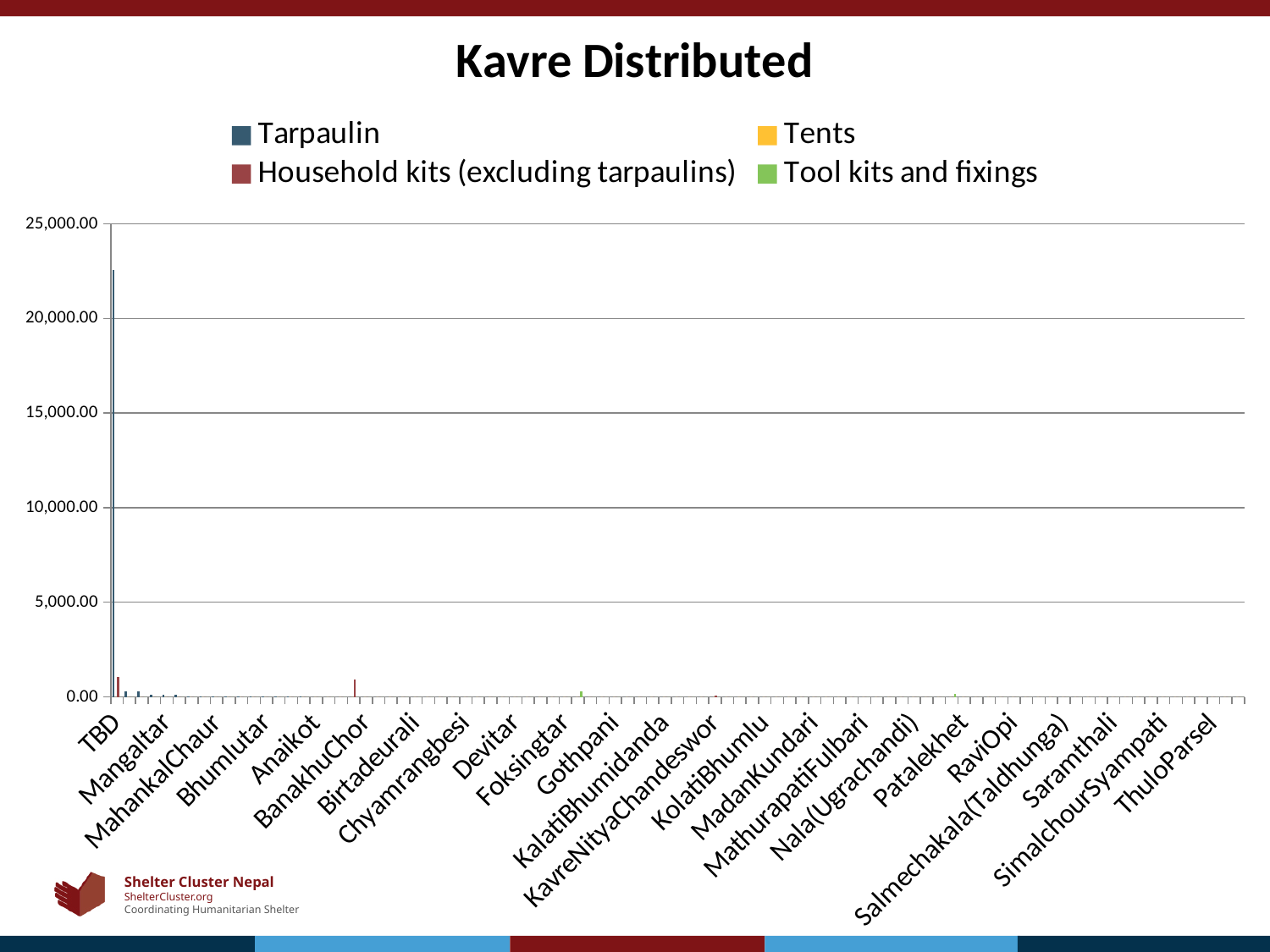
Is the Tarpaulin value for TBD greater or less than 25,000? less Which is larger, the Tarpaulin value for TBD or the Tarpaulin value for Mangaltar? TBD Which series has the tallest bar on the chart? Tarpaulin Is the Household kits (excluding tarpaulins) value for TBD greater or less than 5,000? less What is the title of the chart? Kavre Distributed Which series is shown in green in the legend? Tool kits and fixings What is the highest value shown on the vertical axis? 25,000.00 How many series does the legend list? 4 Which category has the highest Tarpaulin value? TBD What kind of chart is shown on the slide? bar chart Is the Tarpaulin value for TBD greater or less than 20,000? greater